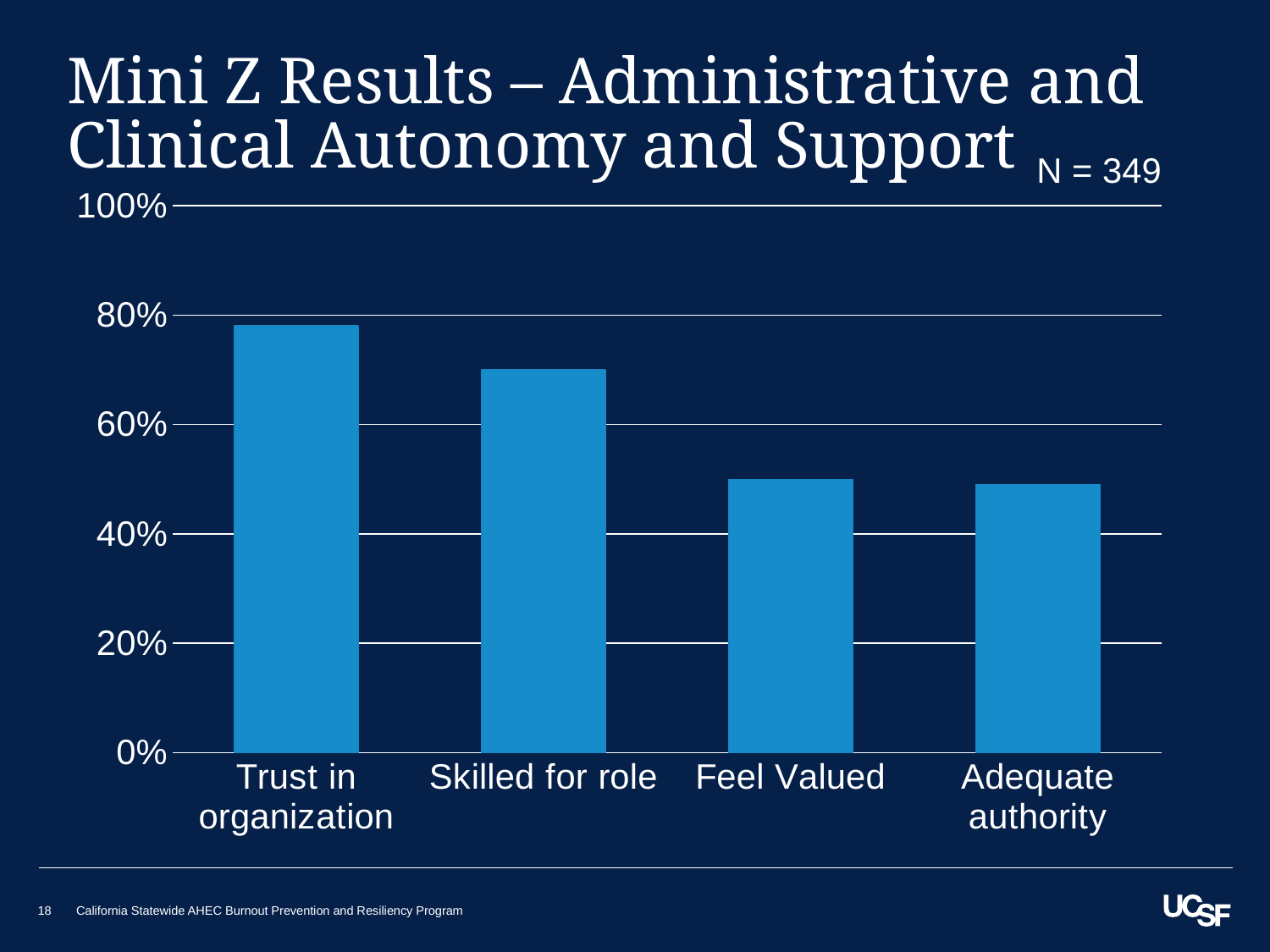
Is the value for Adequate authority greater or less than 60%? less Is the value for Feel Valued greater or less than 40%? greater Do the bar values rise or fall from left to right across the x axis? fall What type of chart is shown on the slide? bar chart Which is larger, the value for Trust in organization or the value for Feel Valued? Trust in organization Is the value for Trust in organization greater or less than 80%? less Which category has the highest bar? Trust in organization How many categories are shown on the x axis of the chart? 4 What sample size (N) is stated on the slide for the chart? N = 349